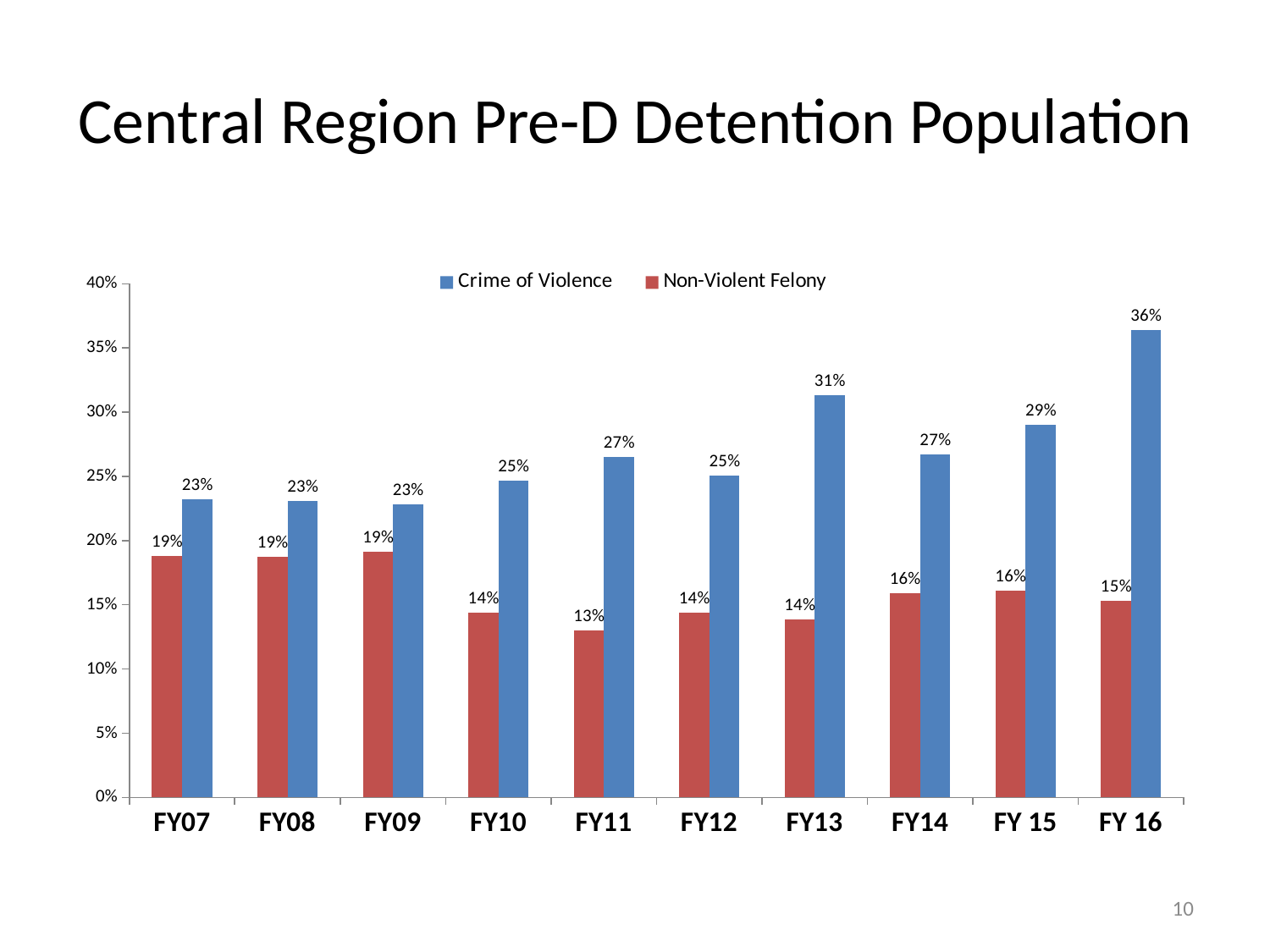
What is the difference between the Crime of Violence and Non-Violent Felony values for FY 16? 21% Which fiscal year has the lowest Non-Violent Felony value? FY11 What is the Crime of Violence value for FY 16? 36% How many fiscal years are shown on the x axis? 10 What is the Non-Violent Felony value for FY11? 13% How many series does the legend list? 2 Which is larger for FY07: Crime of Violence or Non-Violent Felony? Crime of Violence What is the Crime of Violence value for FY13? 31% Is the Crime of Violence value for FY13 greater or less than 30%? greater What is the title of the slide? Central Region Pre-D Detention Population What kind of chart is shown on the slide? Bar chart Which fiscal year has the highest Crime of Violence value? FY 16